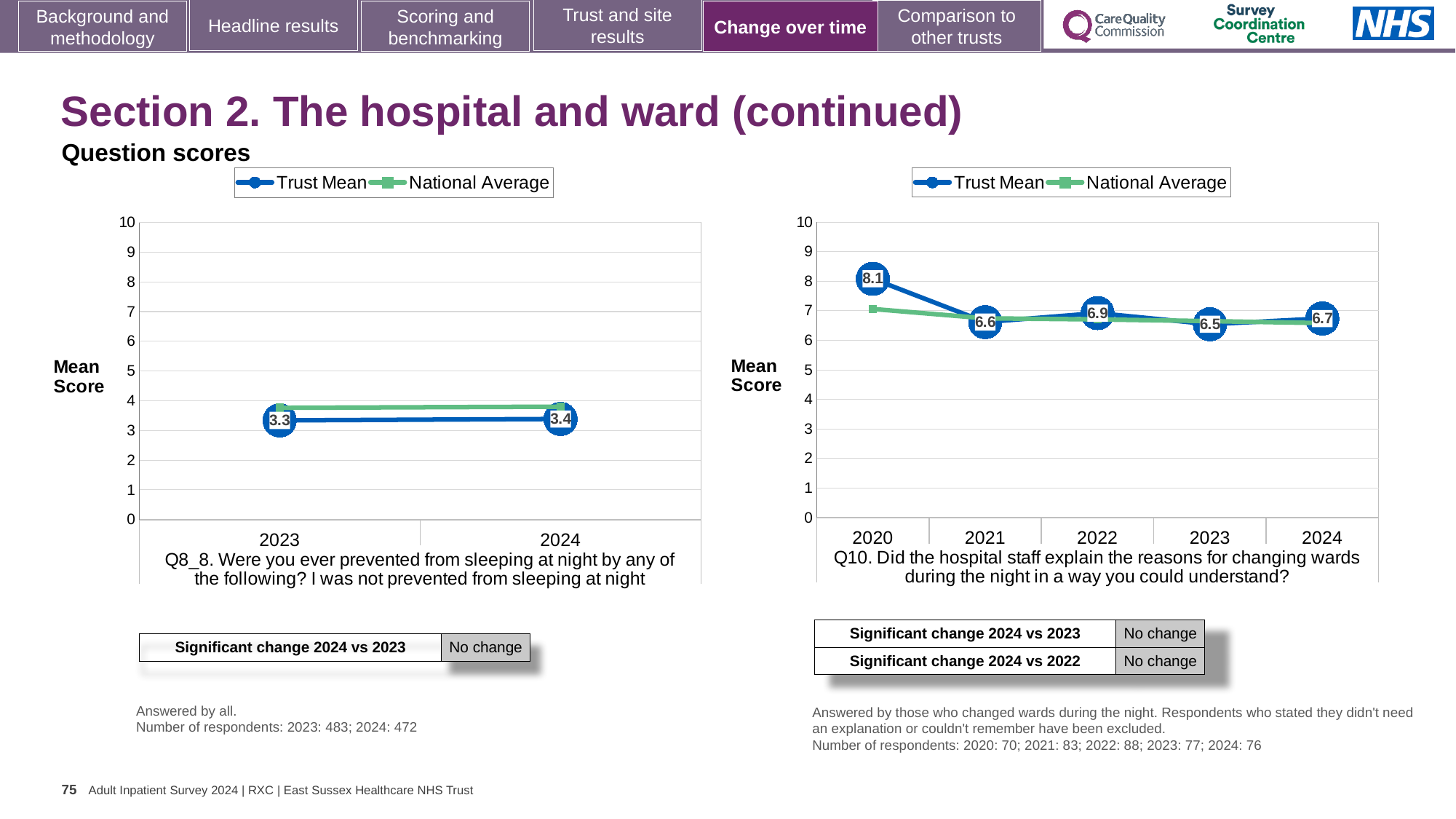
How many years are shown on the x axis of the Q10 chart (right)? 5 In the Q10 chart (right), which year has the highest Trust Mean score? 2020 In the Q10 chart (right), is the Trust Mean score higher in 2022 or in 2023? 2022 In the Q8_8 chart (left), what is the difference between the Trust Mean scores for 2024 and 2023? 0.1 In the Q10 chart (right), is the National Average value for 2020 greater or less than 8? less In the Q8_8 chart (left), is the National Average value for 2023 greater or less than 3? greater What type of chart is the Q10 chart (right)? Line chart In the Q10 chart (right), which year has the lowest Trust Mean score? 2023 In the Q10 chart (right), what is the difference between the Trust Mean scores for 2020 and 2021? 1.5 How many series does the legend of the Q8_8 chart (left) list? 2 In the Q10 chart (right), what is the Trust Mean score for 2020? 8.1 In the Q8_8 chart (left), what is the Trust Mean score for 2024? 3.4